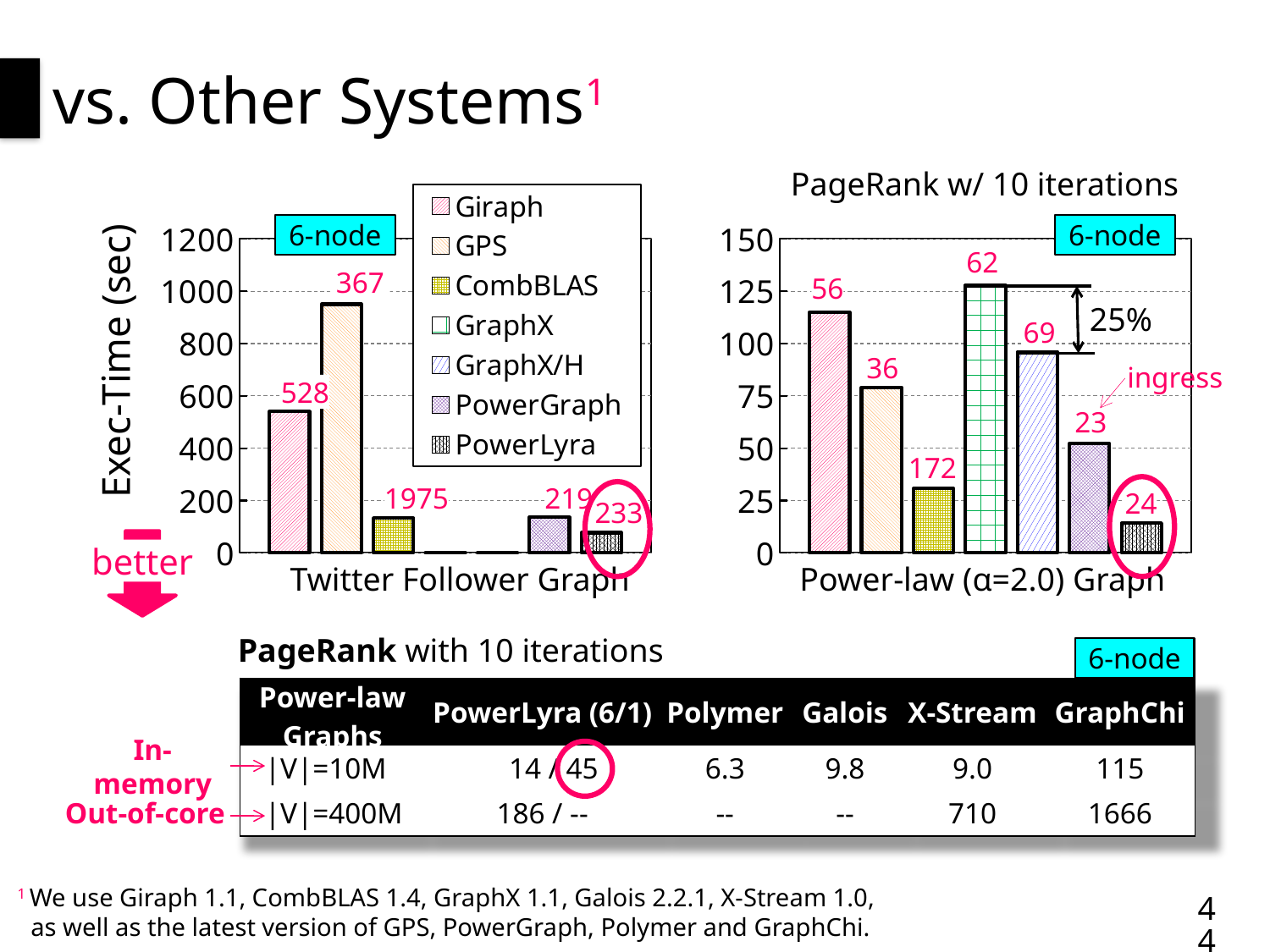
What kind of chart is the left chart (Twitter Follower Graph)? bar chart How many series does the legend list? 7 In the left chart (Twitter Follower Graph), is the execution time for GPS greater or less than 800? greater In the left chart (Twitter Follower Graph), which system has the highest execution time? GPS In the right chart (Power-law (α=2.0) Graph), which system has the lowest execution time? PowerLyra In the right chart (Power-law (α=2.0) Graph), which system has the highest execution time? GraphX What is the label on the y-axis of the left chart? Exec-Time (sec) In the right chart (Power-law (α=2.0) Graph), which has the larger execution time, Giraph or GPS? Giraph In the right chart (Power-law (α=2.0) Graph), is the execution time for PowerLyra greater or less than 25? less In the left chart (Twitter Follower Graph), is the execution time for Giraph greater or less than 400? greater In the right chart (Power-law (α=2.0) Graph), what ingress value is printed above the PowerLyra bar? 24